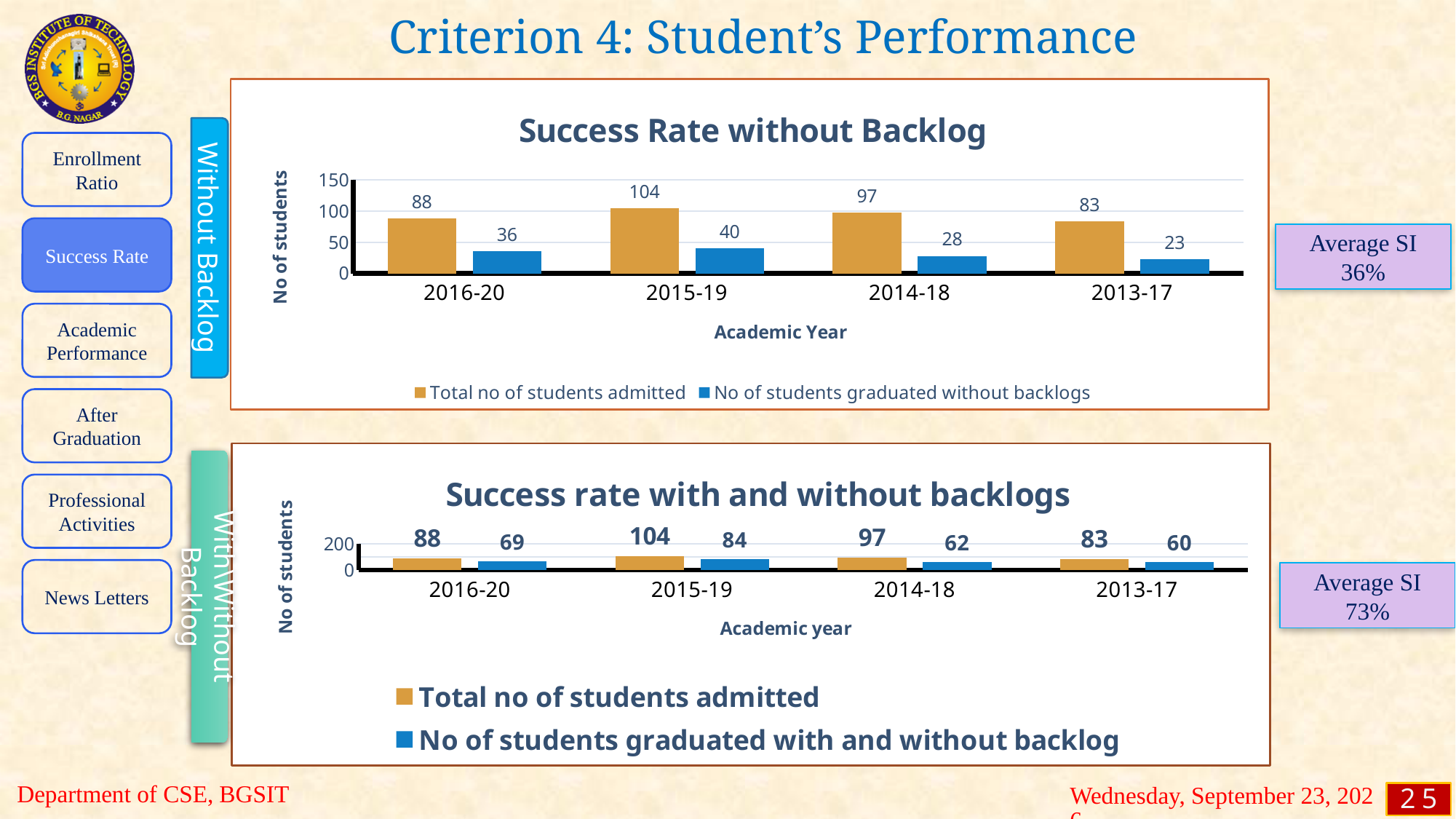
In the 'Success Rate without Backlog' chart, how many academic years are shown on the x axis? 4 In the 'Success Rate without Backlog' chart, what is the difference between the total students admitted and the students graduated without backlogs for 2016-20? 52 In the 'Success rate with and without backlogs' chart, how many series does the legend list? 2 In the 'Success rate with and without backlogs' chart, how many students graduated with and without backlog in 2014-18? 62 In the 'Success rate with and without backlogs' chart, what is the difference between the total students admitted and the students graduated with and without backlog for 2015-19? 20 In the 'Success Rate without Backlog' chart, how many students graduated without backlogs in 2013-17? 23 In the 'Success Rate without Backlog' chart, which academic year has the highest number of students graduated without backlogs? 2015-19 What type of chart is the 'Success Rate without Backlog' chart? Bar chart In the 'Success Rate without Backlog' chart, what is the total number of students admitted for 2015-19? 104 In the 'Success rate with and without backlogs' chart, which academic year has the lowest number of students graduated with and without backlog? 2013-17 In the 'Success Rate without Backlog' chart, which academic year has the lowest total number of students admitted? 2013-17 In the 'Success rate with and without backlogs' chart, what is the total number of students admitted for 2013-17? 83